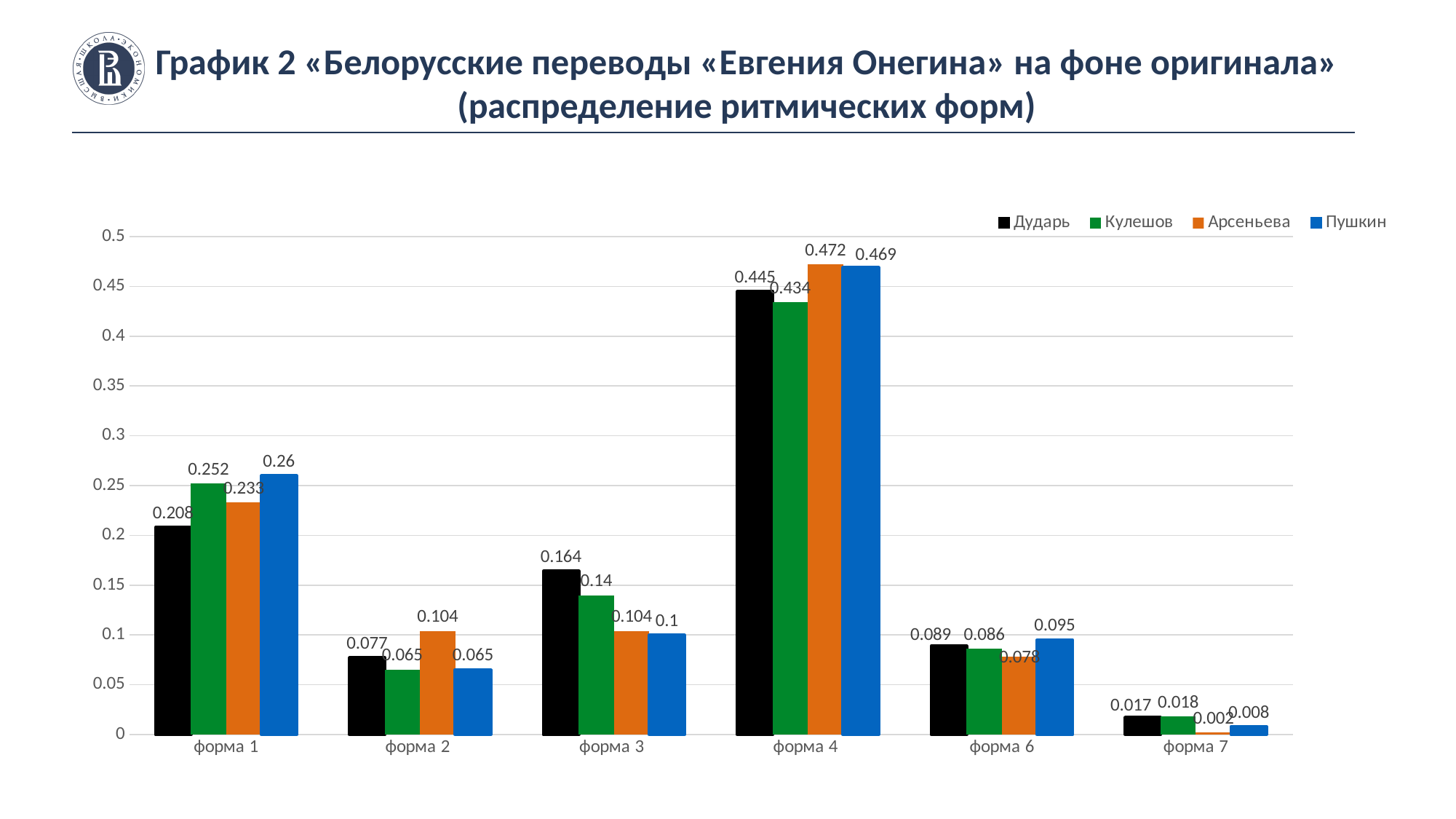
Which category has the highest value for Кулешов? форма 4 What is the value for Арсеньева in форма 2? 0.104 What is the value for Пушкин in форма 4? 0.469 Which series is shown in orange in the legend? Арсеньева Which category has the lowest value for Арсеньева? форма 7 How many categories are shown on the x axis? 6 What is the value for Дударь in форма 3? 0.164 Is the value for Арсеньева in форма 4 greater or less than 0.45? greater Which is larger in форма 3: the value for Дударь or the value for Кулешов? Дударь How many series does the legend list? 4 What is the difference between the Пушкин and Дударь values in форма 1? 0.052 What kind of chart is shown on the slide? bar chart